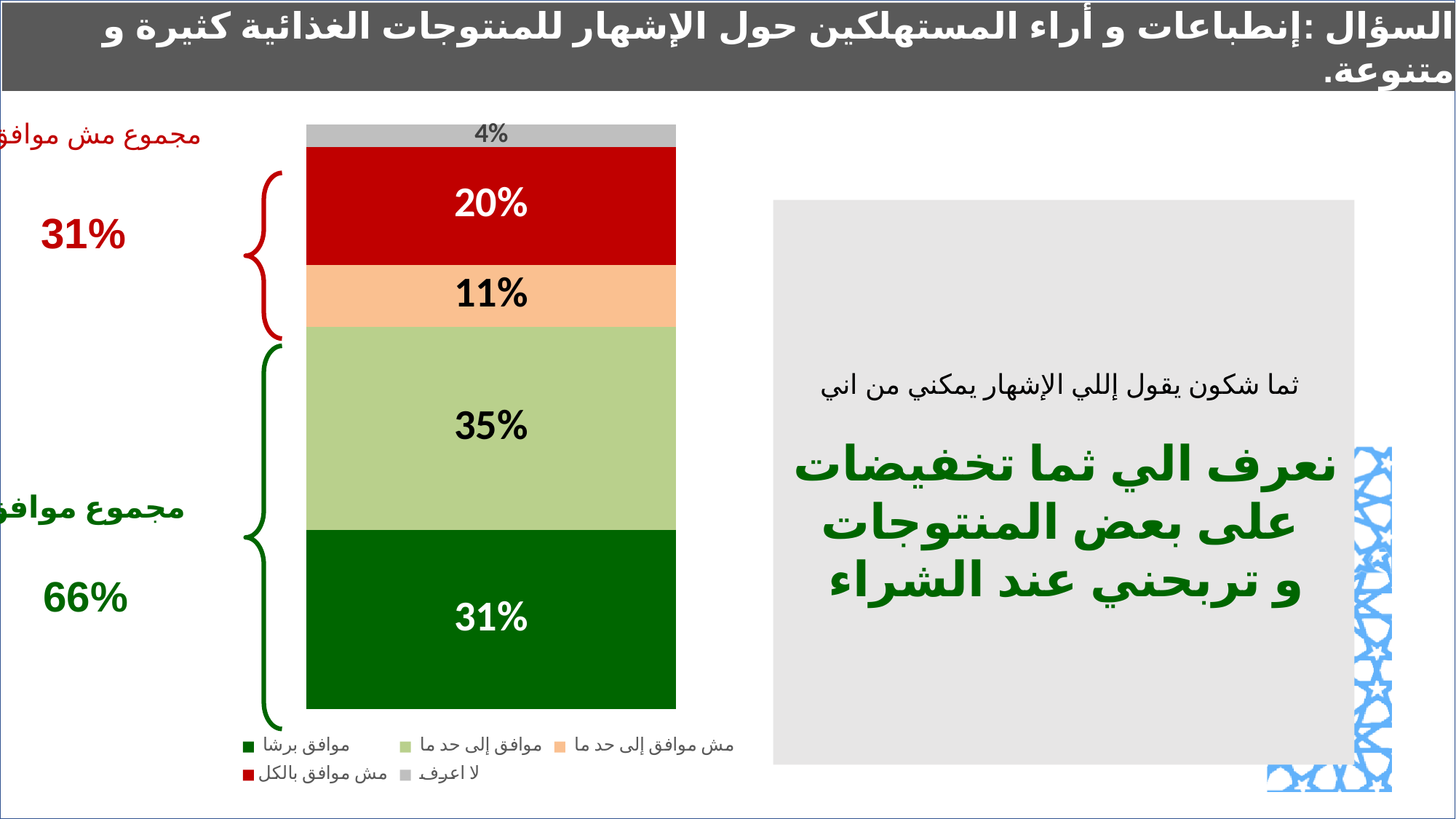
What total is shown for the 'مجموع موافق' bracket? 66% Which is larger, the 'موافق برشا' segment or the 'مش موافق بالكل' segment? موافق برشا Which segment of the bar has the largest value? موافق إلى حد ما How many series does the legend list? 5 Which segment of the bar has the smallest value? لا اعرف What is the value of the 'مش موافق إلى حد ما' segment? 11% What is the value of the 'مش موافق بالكل' segment? 20% What is the value of the 'موافق إلى حد ما' segment? 35% What is the value of the 'لا اعرف' segment? 4% What is the difference between the 'مش موافق بالكل' and 'مش موافق إلى حد ما' segments? 9% What kind of chart is shown on the slide? stacked bar chart What is the value of the 'موافق برشا' segment? 31%